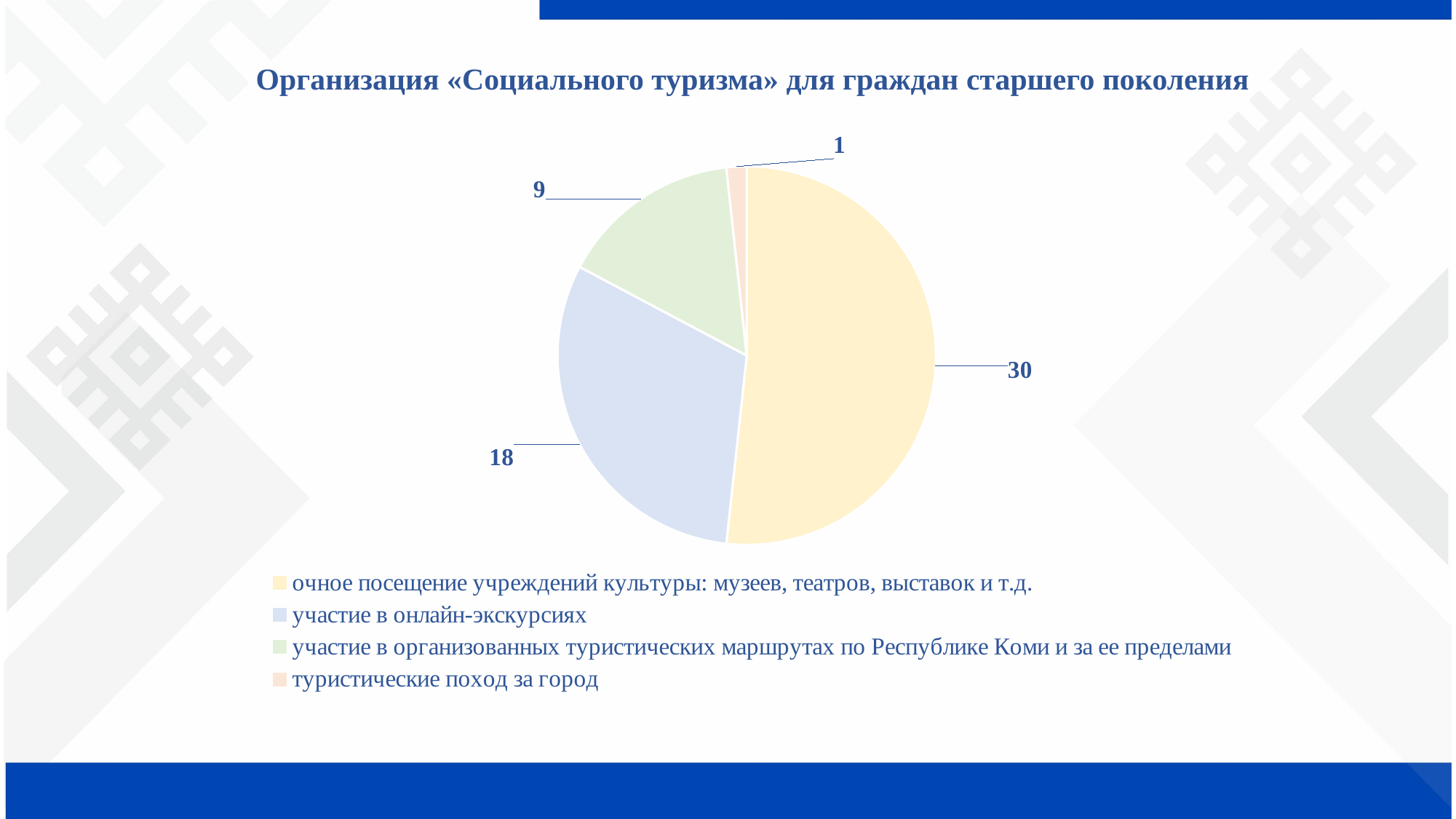
What is the total of all the values shown in the pie chart? 58 Which category has the largest slice of the pie? очное посещение учреждений культуры: музеев, театров, выставок и т.д. What is the value for «туристические поход за город»? 1 What is the value for «участие в онлайн-экскурсиях»? 18 What is the value for «участие в организованных туристических маршрутах по Республике Коми и за ее пределами»? 9 How many slices does the pie chart have? 4 Which category has the smallest slice of the pie? туристические поход за город What is the value for «очное посещение учреждений культуры: музеев, театров, выставок и т.д.»? 30 What kind of chart is shown on the slide? pie chart What is the title of the chart on the slide? Организация «Социального туризма» для граждан старшего поколения What is the difference between the values for «очное посещение учреждений культуры» and «участие в онлайн-экскурсиях»? 12 Which is larger: «участие в онлайн-экскурсиях» or «участие в организованных туристических маршрутах по Республике Коми и за ее пределами»? участие в онлайн-экскурсиях